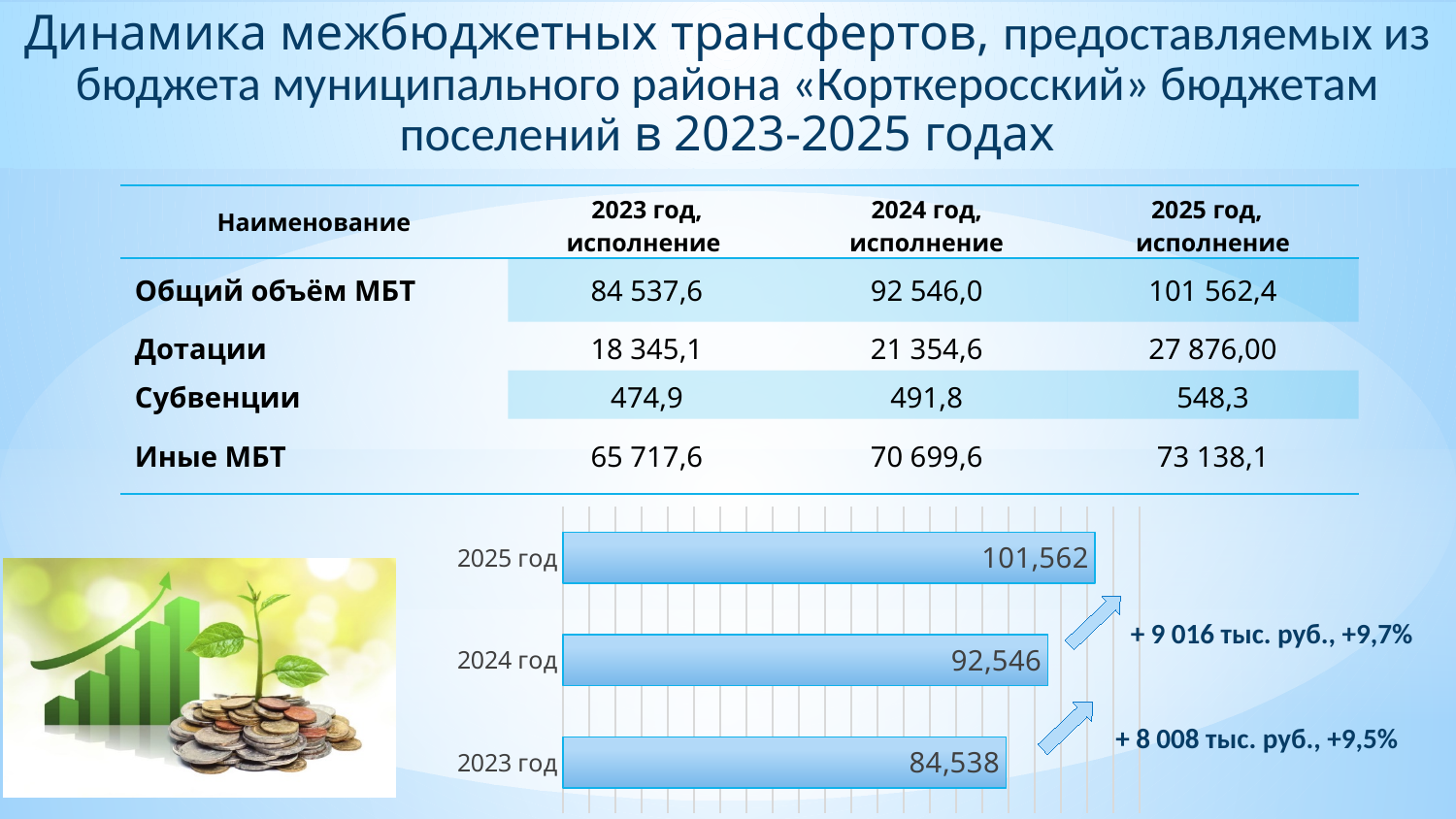
What type of chart is shown on the slide? Bar chart Which is larger, the value for 2024 год or the value for 2023 год? 2024 год What is the difference between the values for 2024 год and 2023 год? 8,008 What is the value of the bar for 2024 год? 92,546 What is the difference between the values for 2025 год and 2023 год? 17,024 What is the value of the bar for 2025 год? 101,562 Do the values in the chart rise or fall from 2023 год to 2025 год? Rise Which year has the highest bar in the chart? 2025 год What is the value of the bar for 2023 год? 84,538 What is the difference between the values for 2025 год and 2024 год? 9,016 How many bars are shown in the chart? 3 Which year has the lowest bar in the chart? 2023 год